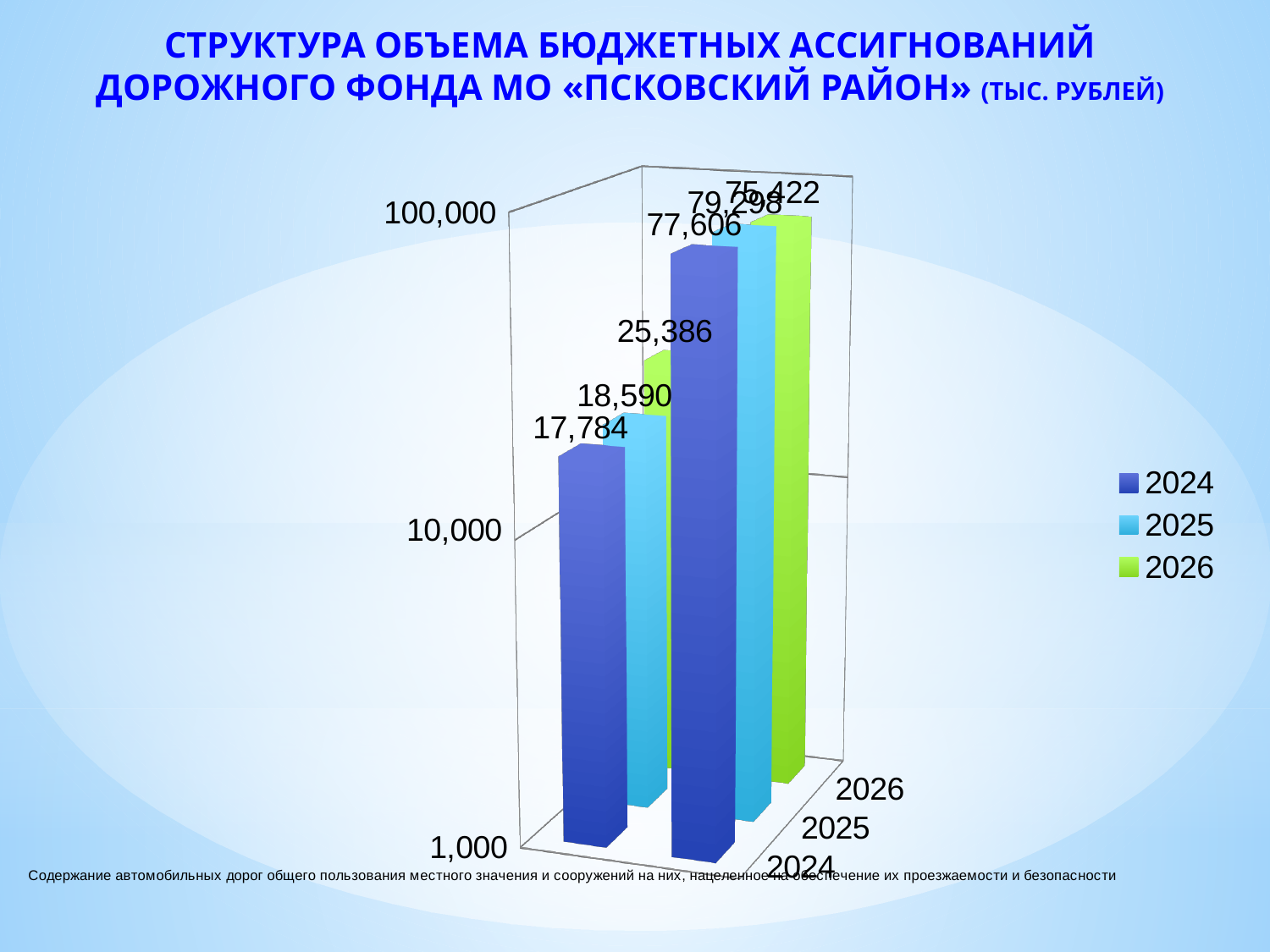
In the right group of bars, which is larger: the value for 2025 or the value for 2026? 2025 In the left group of bars, what is the value for 2025? 18,590 In the right group of bars, what is the value for 2025? 79,298 In the left group of bars, which year has the highest value? 2026 What kind of chart is shown on the slide? bar chart In the right group of bars, what is the value for 2024? 77,606 In the left group of bars, what is the value for 2024? 17,784 How many series does the legend list? 3 In the right group of bars, what is the value for 2026? 75,422 In the right group of bars, which year has the lowest value? 2026 In the left group of bars, what is the difference between the 2026 value and the 2024 value? 7,602 In the left group of bars, what is the value for 2026? 25,386